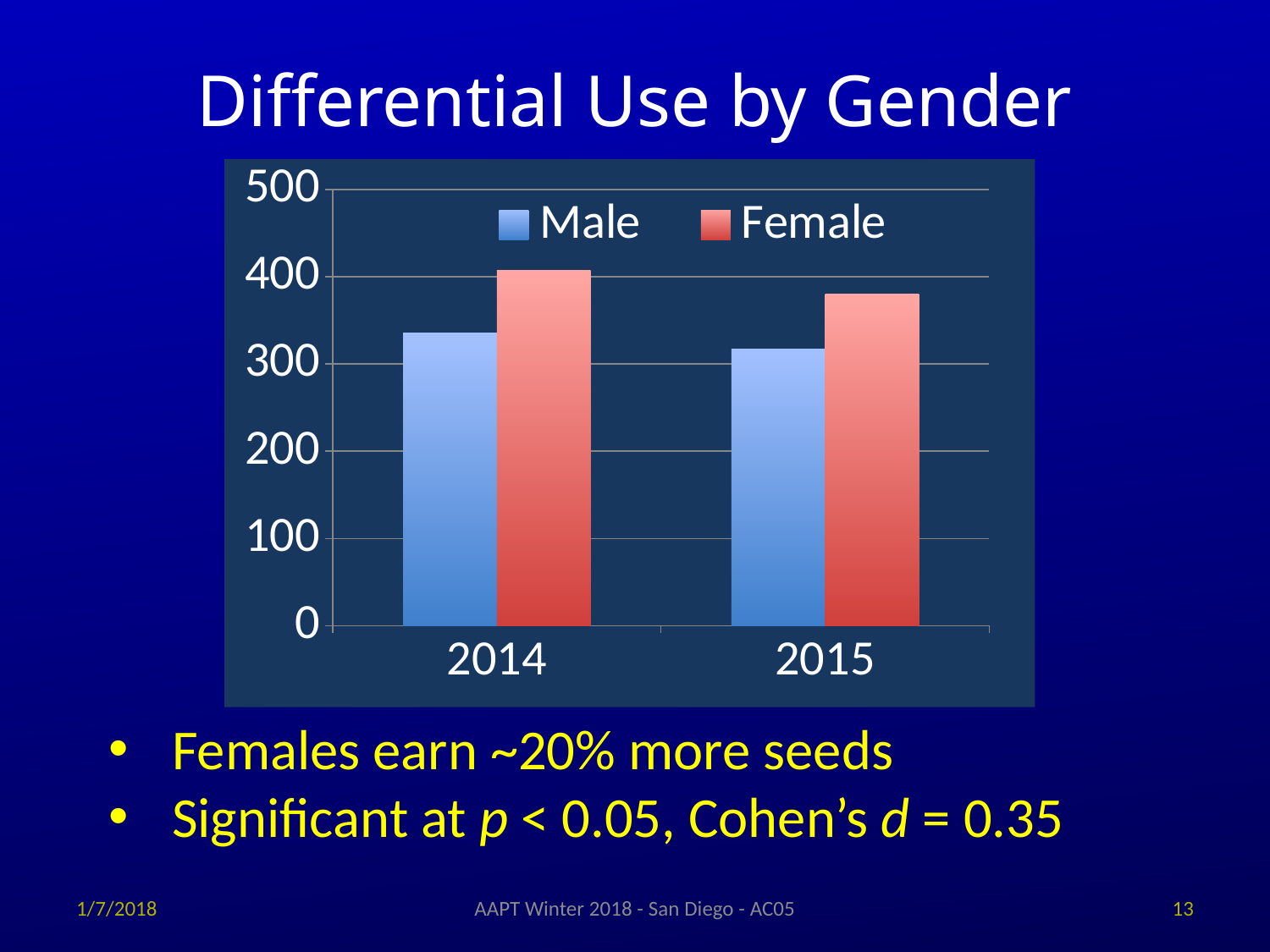
Which series is shown in blue in the chart? Male Is the Male value for 2014 greater or less than 300? greater In 2014, which is larger, the Male value or the Female value? Female Which bar is the lowest in the chart? Male in 2015 Which bar is the highest in the chart? Female in 2014 Is the Female value for 2015 greater or less than 400? less How many series does the chart legend list? 2 Does the Male value rise or fall from 2014 to 2015? fall What kind of chart is shown on the slide? bar chart How many year categories are shown on the x axis of the chart? 2 In 2015, which is larger, the Male value or the Female value? Female Which series is shown in red in the chart? Female